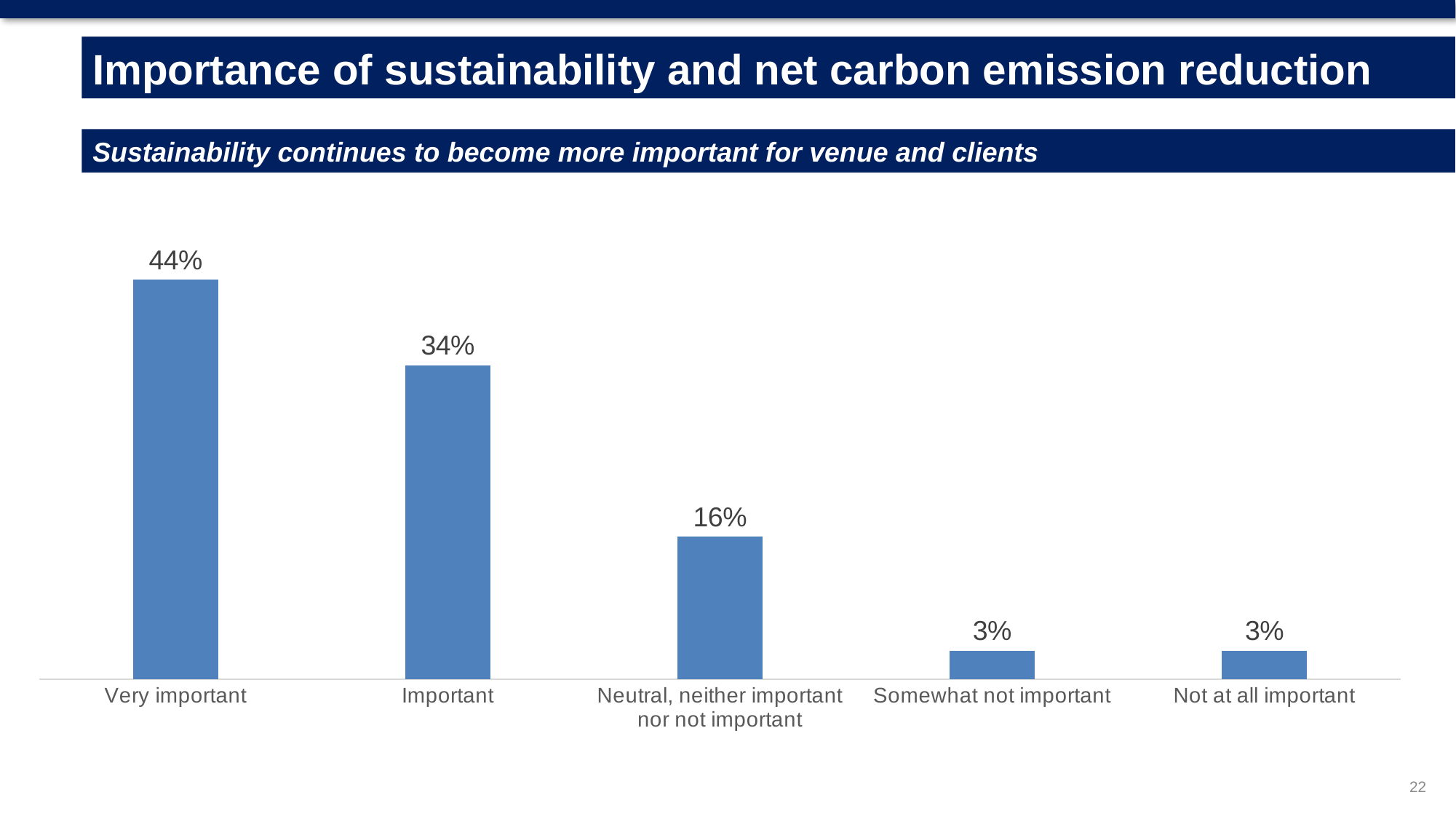
What kind of chart is shown on the slide? Bar chart Which is larger, the value for 'Important' or the value for 'Neutral, neither important nor not important'? Important How many categories are shown on the chart? 5 What percentage is shown for 'Neutral, neither important nor not important'? 16% What is the title of the slide containing the chart? Importance of sustainability and net carbon emission reduction What is the value shown for the 'Important' category? 34% Do the values rise or fall moving from left to right across the categories? Fall What is the value for 'Somewhat not important'? 3% What is the difference between the 'Very important' and 'Important' values? 10% What percentage of respondents rated sustainability as 'Very important'? 44% What is the difference between the 'Important' and 'Neutral, neither important nor not important' values? 18% Which category has the highest value? Very important